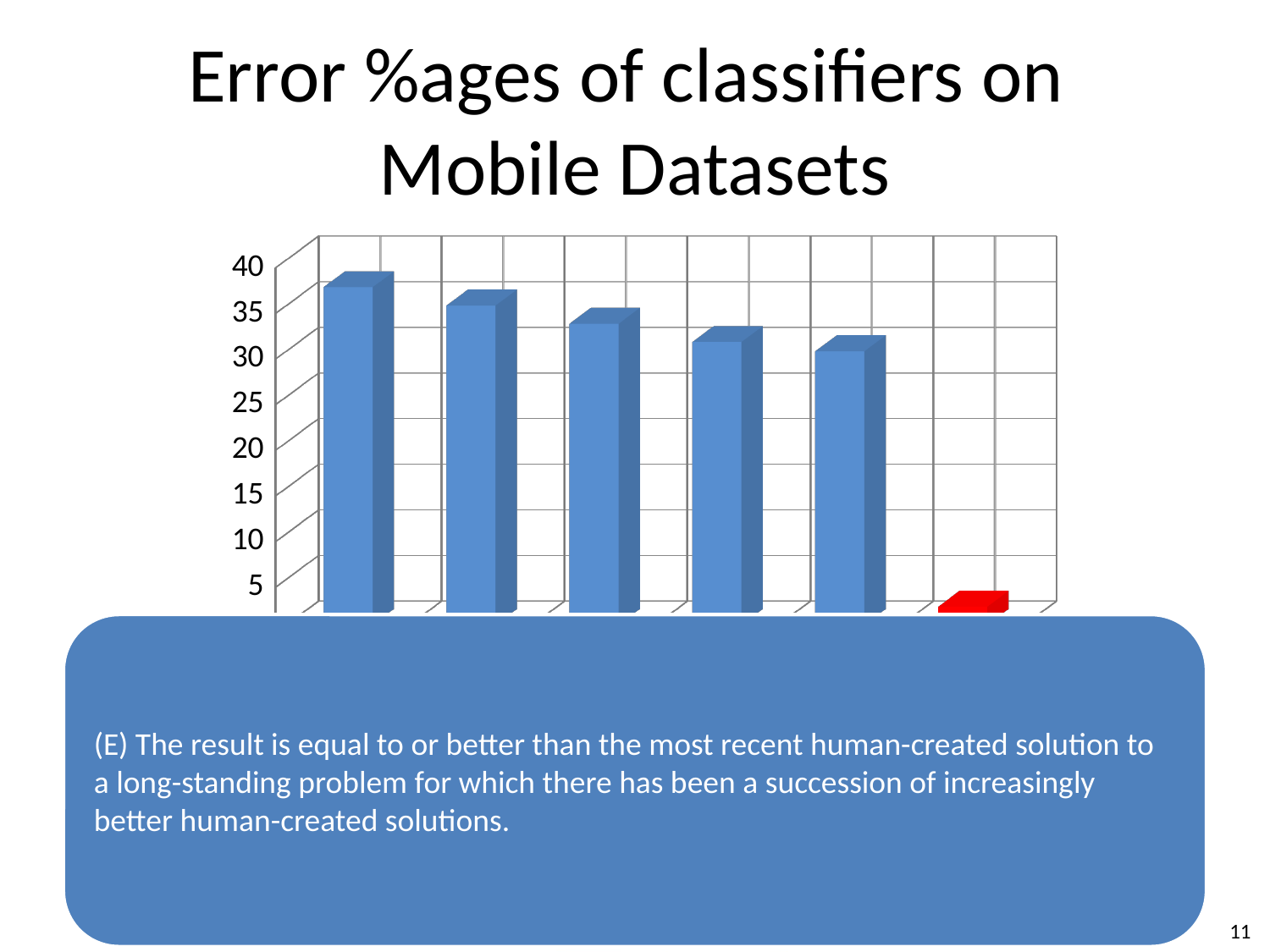
What kind of chart is shown on the slide? bar chart Is the value of the leftmost bar greater or less than 30? greater Is the value of the second bar from the left greater or less than 25? greater Which bar is the tallest in the chart? the leftmost bar Is the value of the rightmost (red) bar greater or less than 5? less Do the bar values rise or fall from left to right across the chart? fall How many bars are plotted in the chart? 6 Which bar is the shortest in the chart? the rightmost (red) bar What is the title of the chart on the slide? Error %ages of classifiers on Mobile Datasets What colour is the shortest bar in the chart? red Which is larger, the leftmost bar or the rightmost bar? the leftmost bar